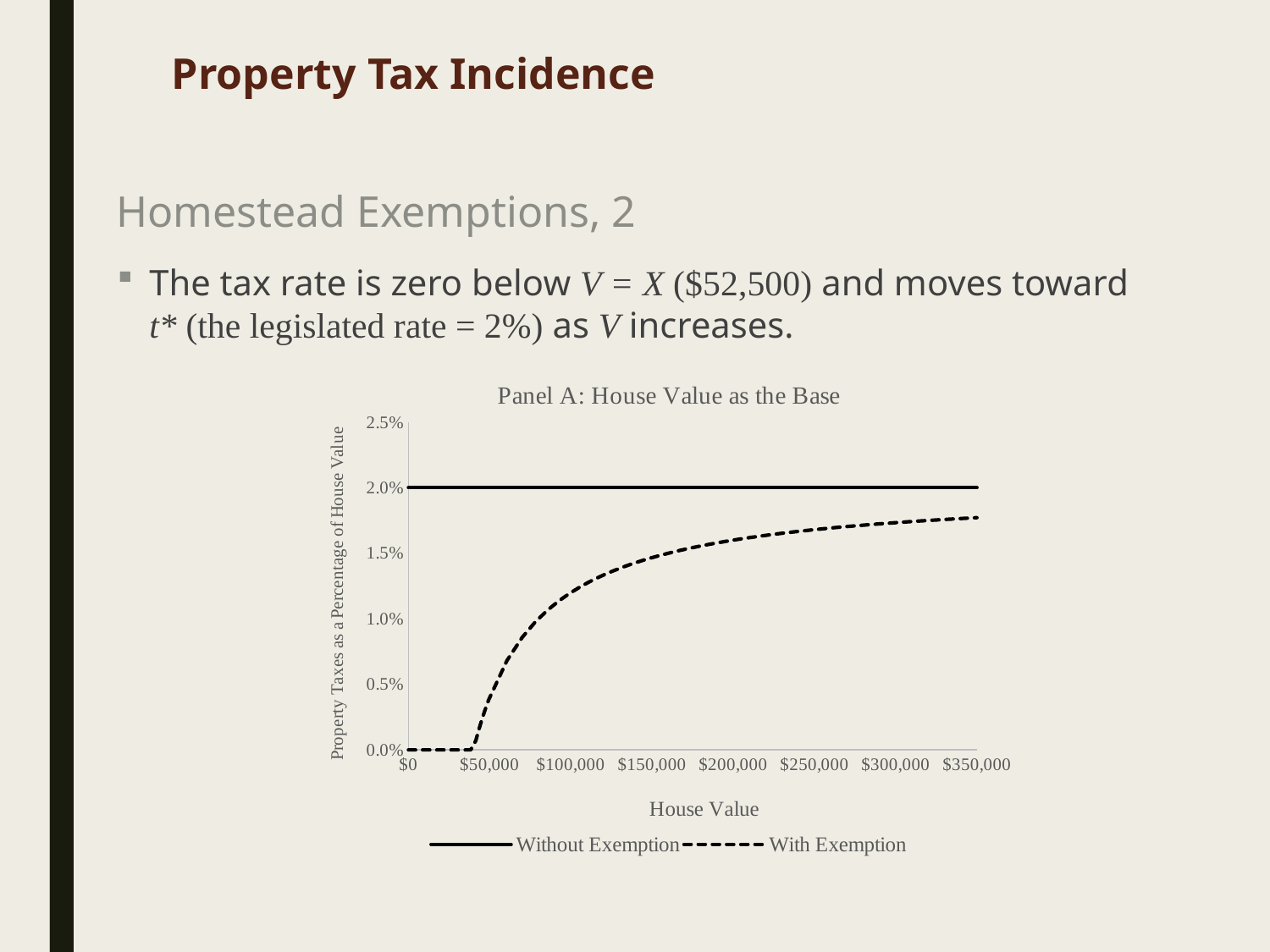
What is the value of the Without Exemption series across all house values? 2.0% Is the value of the With Exemption series at $150,000 greater or less than 1.0%? greater What is the value of the With Exemption series at a house value of $0? 0.0% Is the value of the With Exemption series at $350,000 greater or less than 2.0%? less How many series does the chart's legend list? 2 Is the value of the With Exemption series at $300,000 greater or less than 1.5%? greater What kind of chart is shown on the slide? line chart Which series is drawn with a dashed line? With Exemption At a house value of $200,000, which series has the higher value, Without Exemption or With Exemption? Without Exemption Does the With Exemption series rise or fall as house value increases? rises What is the title of the chart? Panel A: House Value as the Base